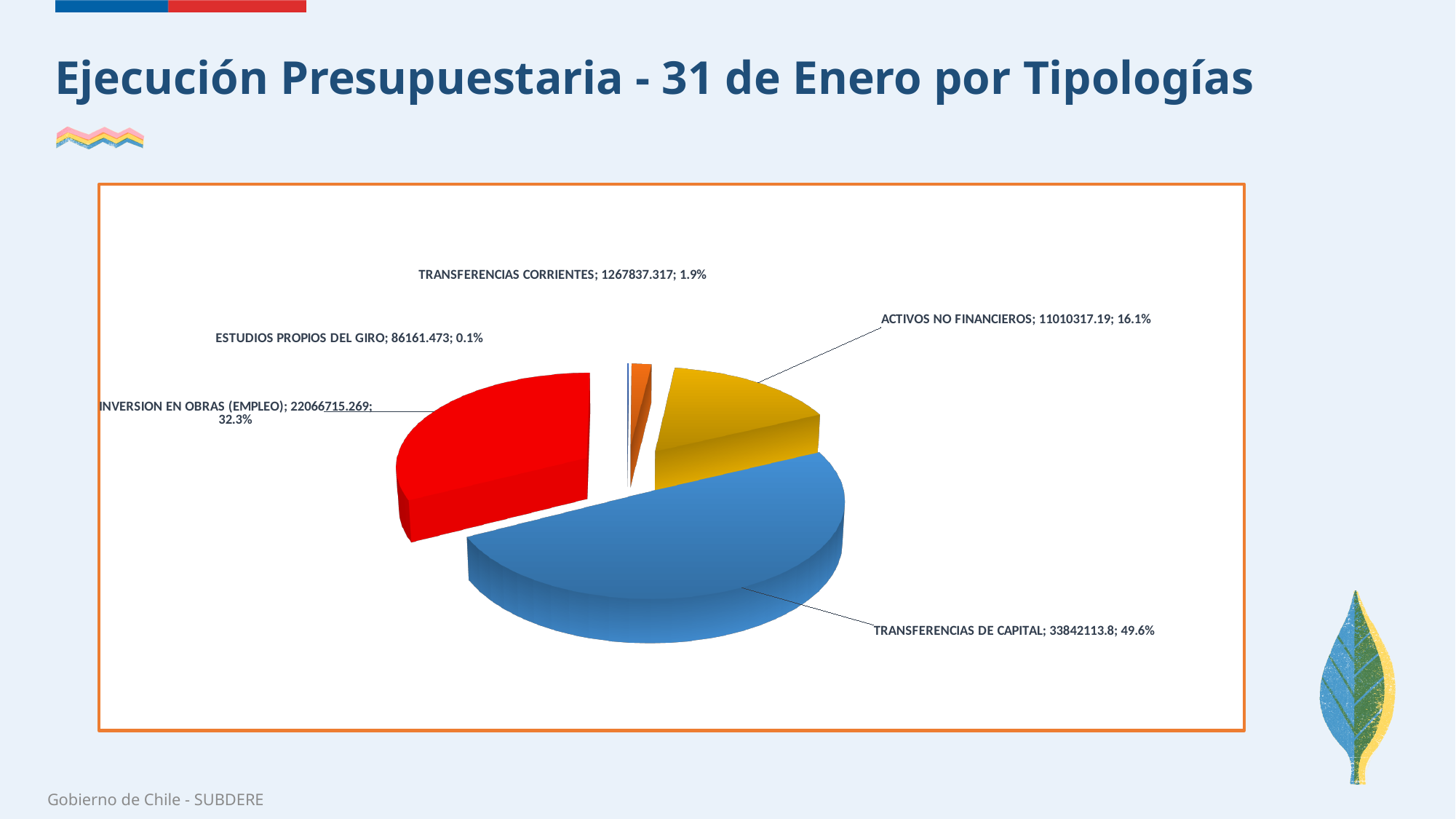
Which is larger, the share for ACTIVOS NO FINANCIEROS or the share for TRANSFERENCIAS CORRIENTES? ACTIVOS NO FINANCIEROS What percentage share does INVERSION EN OBRAS (EMPLEO) have? 32.3% Which category has the smallest share of the pie? ESTUDIOS PROPIOS DEL GIRO What is the difference in percentage points between the shares of TRANSFERENCIAS DE CAPITAL and INVERSION EN OBRAS (EMPLEO)? 17.3 What kind of chart is shown on the slide? Pie chart How many slices does the pie chart have? 5 What value is shown for ACTIVOS NO FINANCIEROS? 11010317.19 What value is shown for TRANSFERENCIAS DE CAPITAL? 33842113.8 What value is shown for TRANSFERENCIAS CORRIENTES? 1267837.317 Which category has the largest share of the pie? TRANSFERENCIAS DE CAPITAL What percentage share does ESTUDIOS PROPIOS DEL GIRO have? 0.1% What colour is the slice for INVERSION EN OBRAS (EMPLEO)? Red